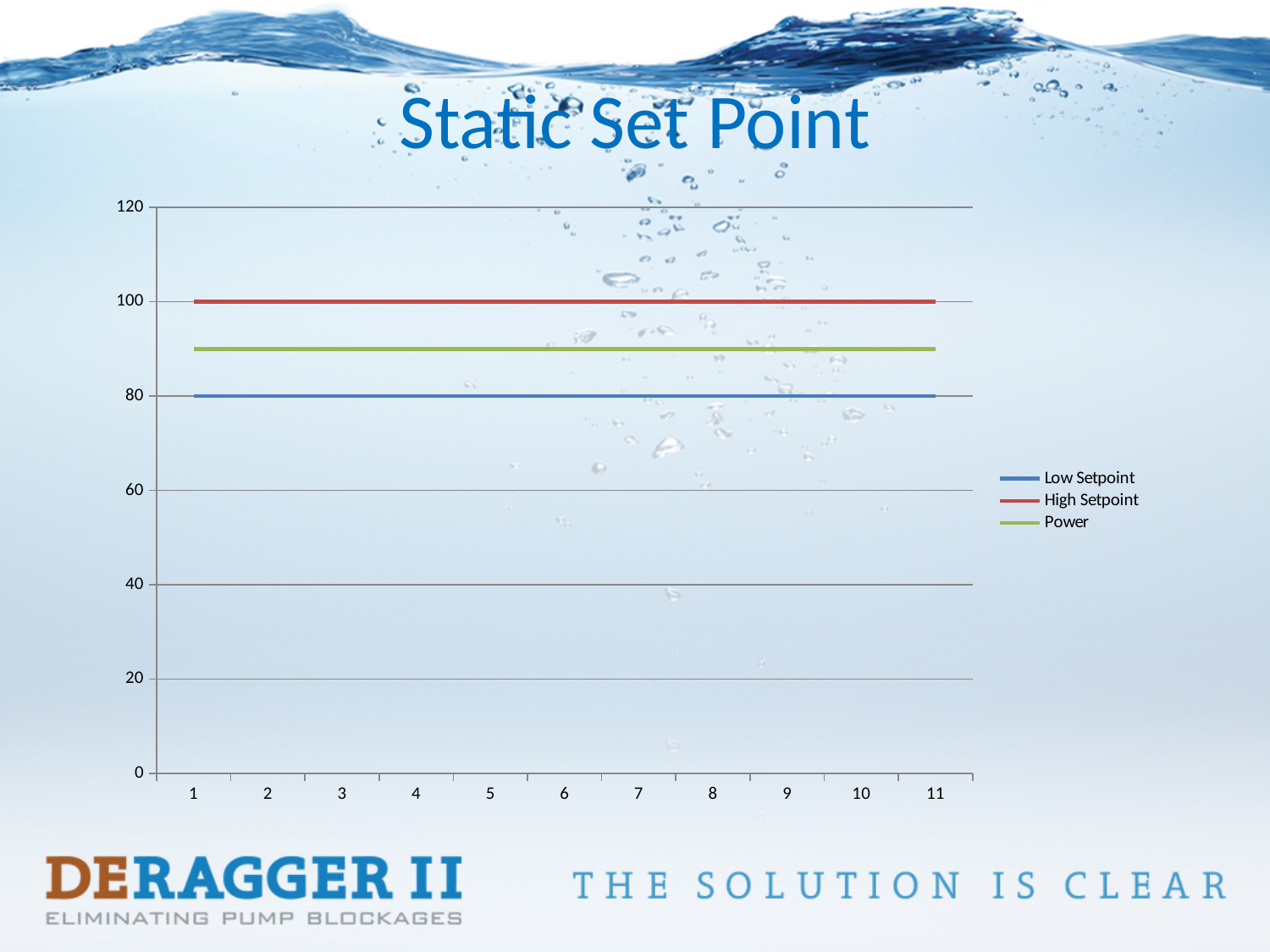
What is the difference between the High Setpoint and the Low Setpoint values? 20 Does the Low Setpoint line rise, fall, or stay flat from x = 1 to x = 11? stays flat What kind of chart is shown on the slide? line chart What is the value of the Low Setpoint line? 80 Which series has the lowest value? Low Setpoint Which series has the highest value? High Setpoint What is the value of the High Setpoint line? 100 Is the value of the Power line greater or less than 80? greater Is the value of the Power line greater or less than 100? less How many series does the legend list? 3 How many points are plotted along the x axis for each series? 11 What is the title of the chart? Static Set Point